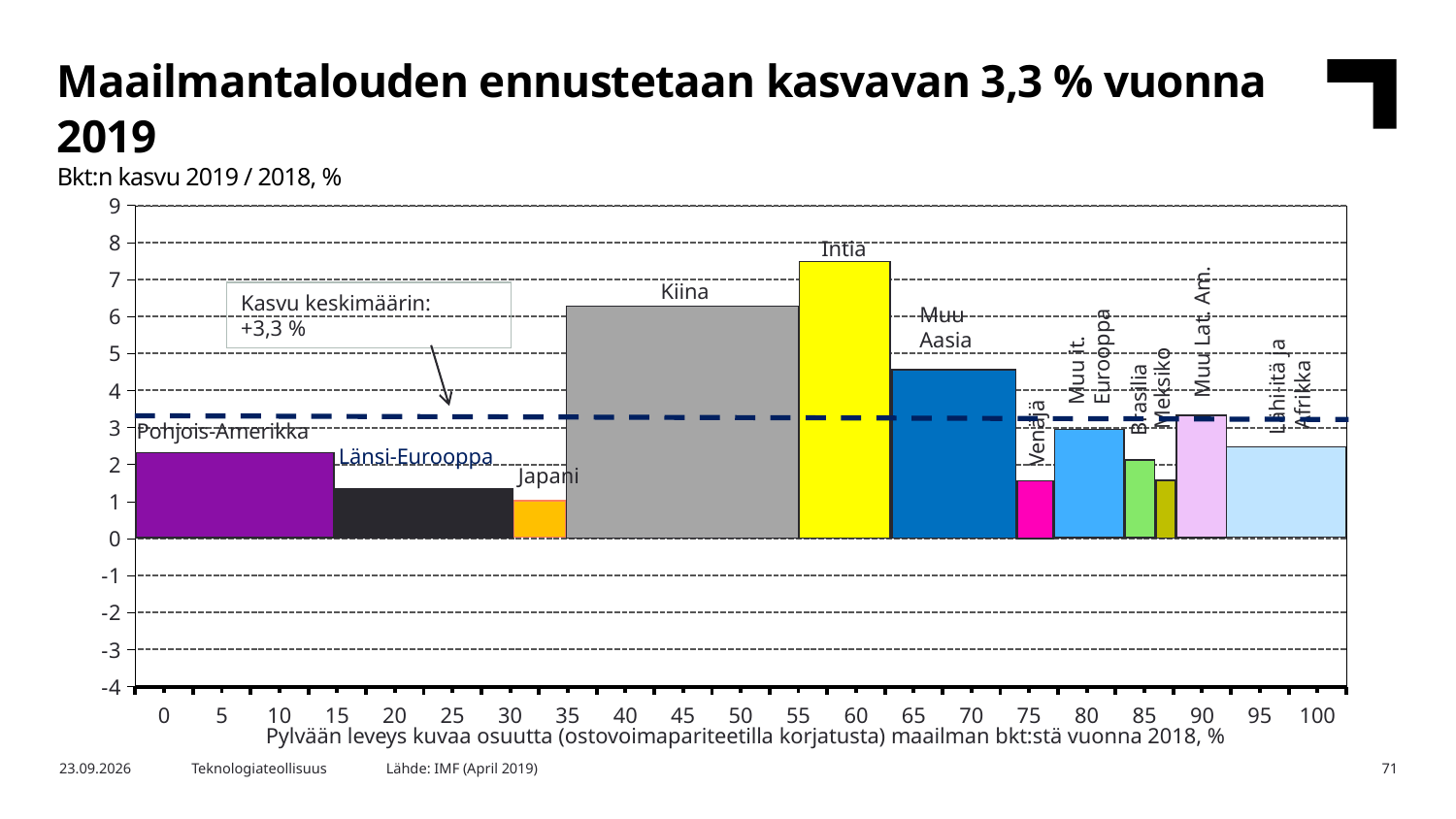
Is the value for Japani greater or less than 2? less Is the value for Intia greater or less than 7? greater Which has the higher growth forecast, Pohjois-Amerikka or Japani? Pohjois-Amerikka How many regions or countries are shown as bars in the chart? 12 According to the note under the x axis, what does the width of each bar represent? Share of world GDP in 2018 (PPP-adjusted) Is the value for Kiina greater or less than 6? greater What kind of chart is shown on the slide? bar chart Which region or country has the lowest GDP growth forecast in the chart? Japani What is the average growth (Kasvu keskimäärin) shown by the dashed line in the chart? +3,3 % Which has the higher growth forecast, Kiina or Intia? Intia Which region or country has the highest GDP growth forecast in the chart? Intia